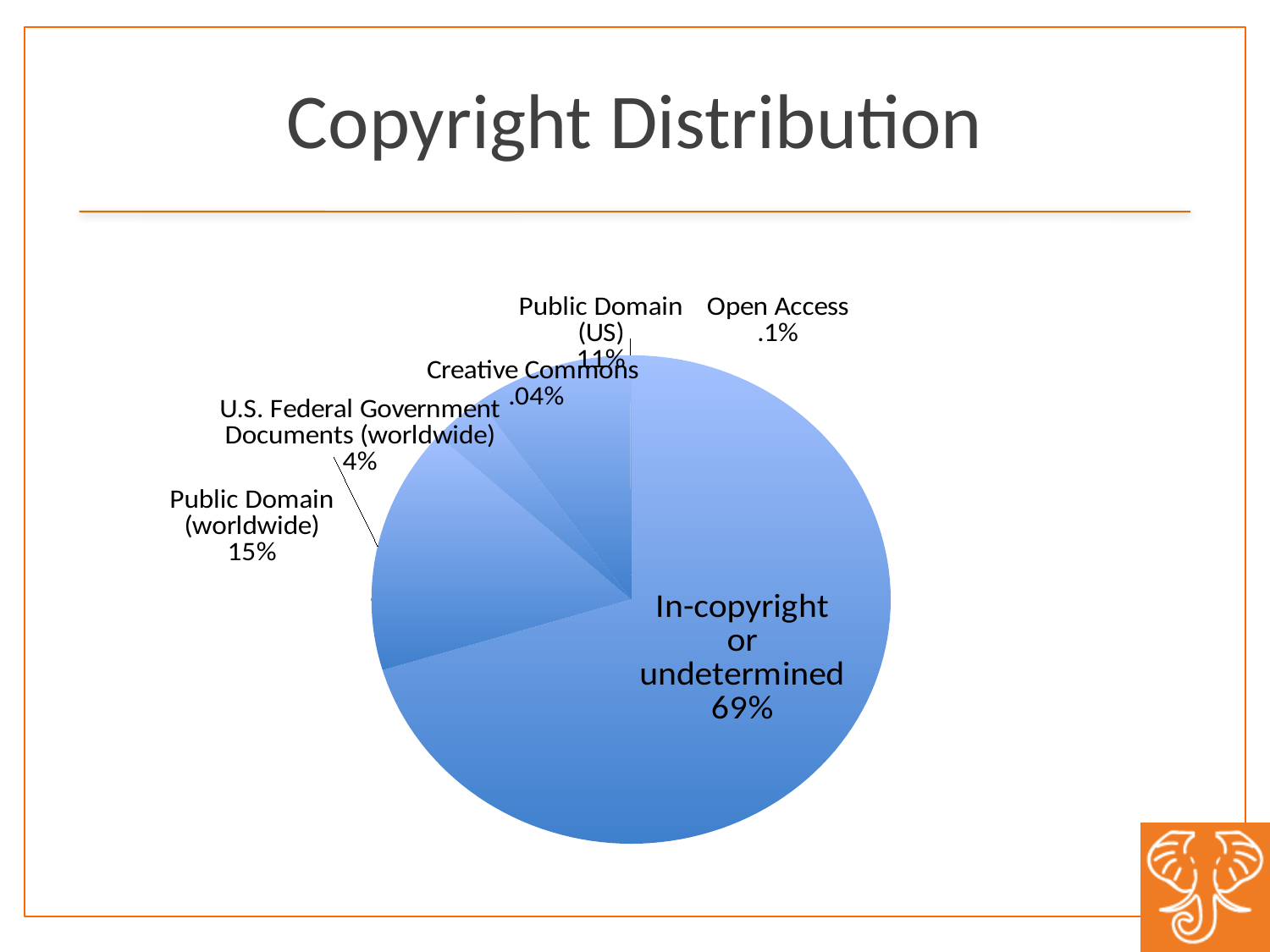
What share of the pie is Creative Commons? .04% What is the difference in percentage points between In-copyright or undetermined and Public Domain (worldwide)? 54 How many categories are shown in the pie chart? 6 What is the title of the chart? Copyright Distribution Which category has the largest slice of the pie? In-copyright or undetermined What share of the pie is Open Access? .1% Which is larger, Public Domain (worldwide) or U.S. Federal Government Documents (worldwide)? Public Domain (worldwide) Which category has the smallest slice of the pie? Creative Commons What kind of chart is shown on the slide? pie chart What share of the pie is U.S. Federal Government Documents (worldwide)? 4%